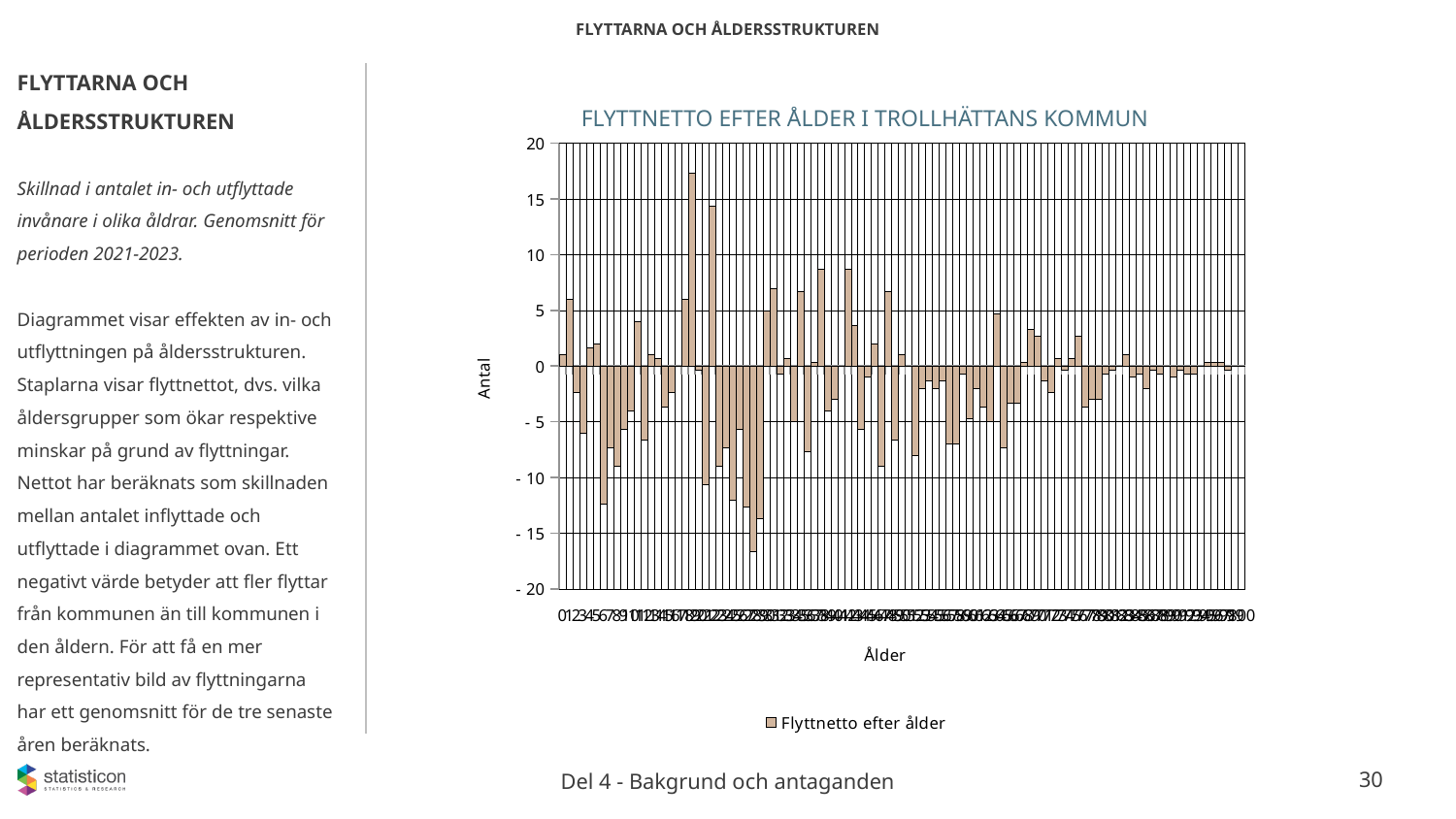
Is the lowest value plotted in the chart greater or less than -15? less Is the highest value plotted in the chart greater or less than 20? less What is the title of the chart? FLYTTNETTO EFTER ÅLDER I TROLLHÄTTANS KOMMUN What is the legend entry shown below the chart? Flyttnetto efter ålder How many series does the legend of the chart list? 1 Is the highest value plotted in the chart greater or less than 15? greater What kind of chart is shown on the slide? bar chart